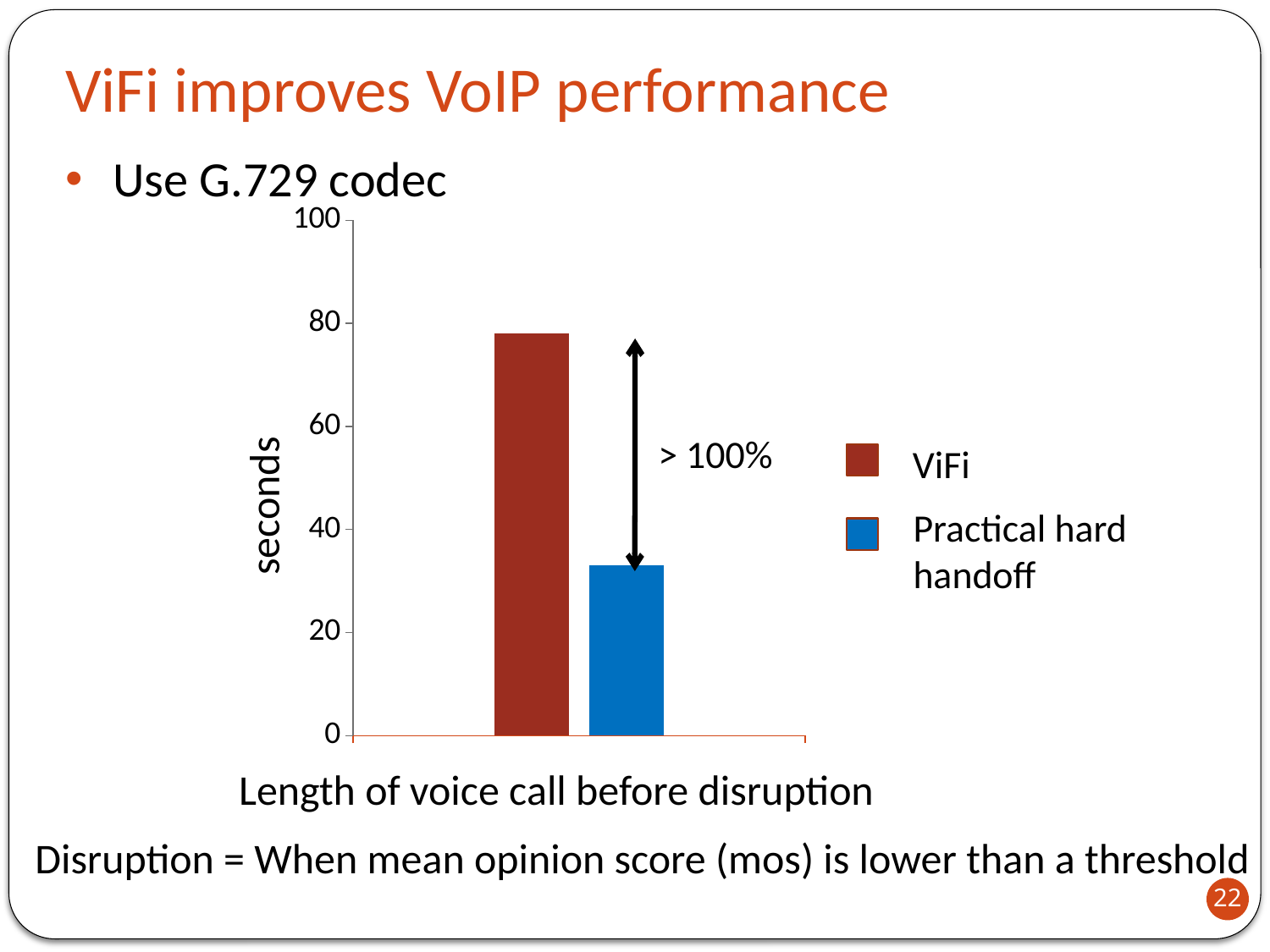
How many bars are plotted in the chart? 2 How many series does the legend list? 2 What kind of chart is shown on the slide? bar chart Is the value for Practical hard handoff greater or less than 40? less Which series has the lowest value in the chart? Practical hard handoff Is the value for ViFi greater or less than 60? greater What percentage improvement is annotated between the two bars? > 100% Which series has the highest value in the chart? ViFi What is the label on the vertical axis of the chart? seconds Is the value for Practical hard handoff greater or less than 20? greater Which is larger, the value for ViFi or the value for Practical hard handoff? ViFi